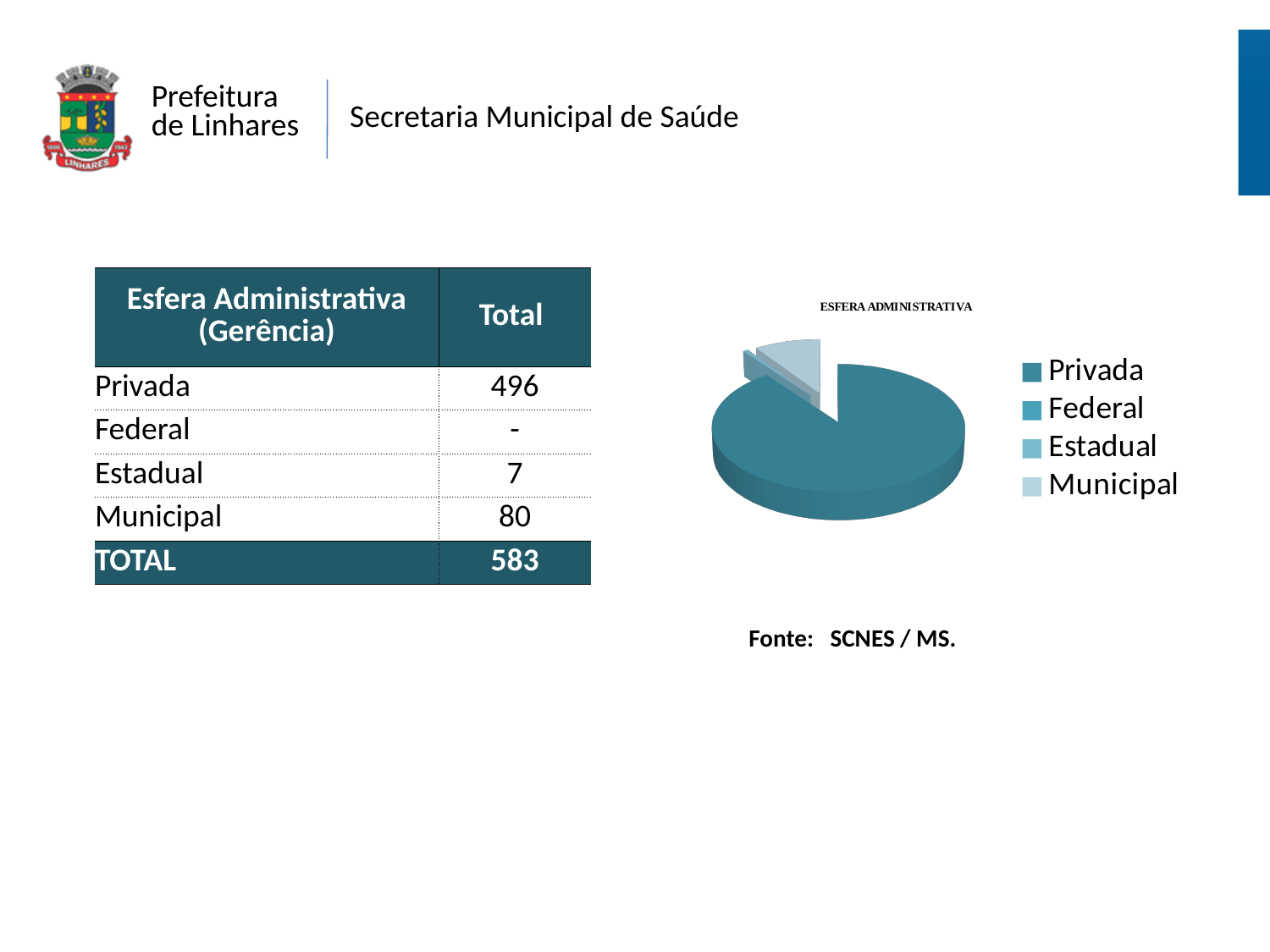
What is the value for Estadual? 7 What is the difference between the values for Privada and Municipal? 416 Which category has the largest slice in the pie chart? Privada Which category has the smallest visible slice in the pie chart? Estadual How many entries does the legend of the pie chart list? 4 What is the value for Municipal? 80 Which is larger, the value for Municipal or the value for Estadual? Municipal Which legend entry is listed last in the pie chart's legend? Municipal What is the value for Privada? 496 What kind of chart is shown on the slide? pie chart What is the total across all categories shown? 583 What is the title of the pie chart? ESFERA ADMINISTRATIVA